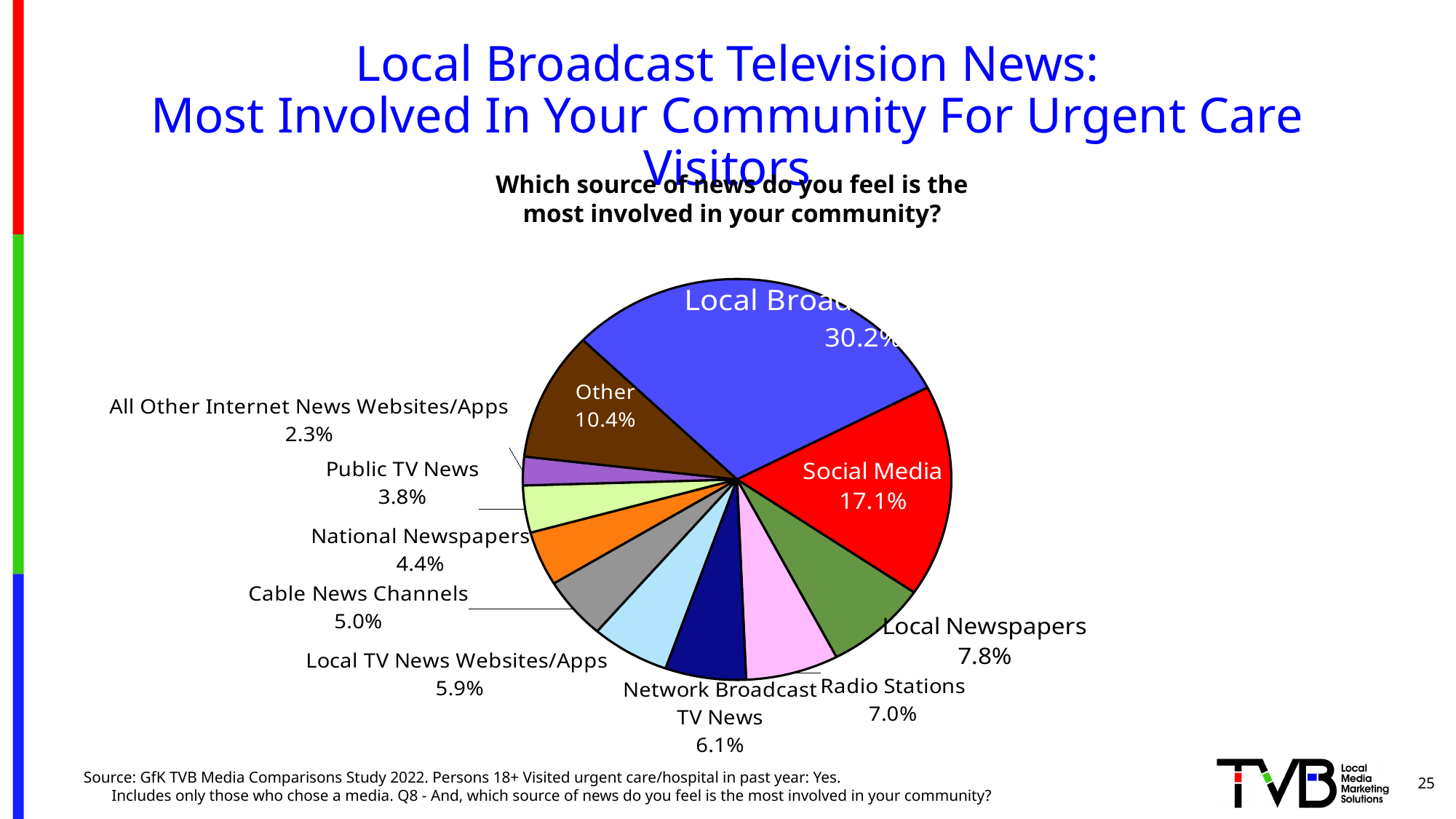
What percentage is shown for Local Newspapers? 7.8% What question is the pie chart based on, as stated in the chart subtitle? Which source of news do you feel is the most involved in your community? What percentage is shown for Cable News Channels? 5.0% What type of chart is shown on the slide? pie chart What percentage is shown for Radio Stations? 7.0% How many slices does the pie chart have? 11 What is the share for the 'Other' slice? 10.4% What share of respondents chose Social Media as the news source most involved in their community? 17.1% What is the difference in percentage points between Social Media and Local Newspapers? 9.3 percentage points What is the largest percentage shown on the pie chart? 30.2% Which has a larger share, Network Broadcast TV News or Local TV News Websites/Apps? Network Broadcast TV News Which category has the smallest share in the pie chart? All Other Internet News Websites/Apps